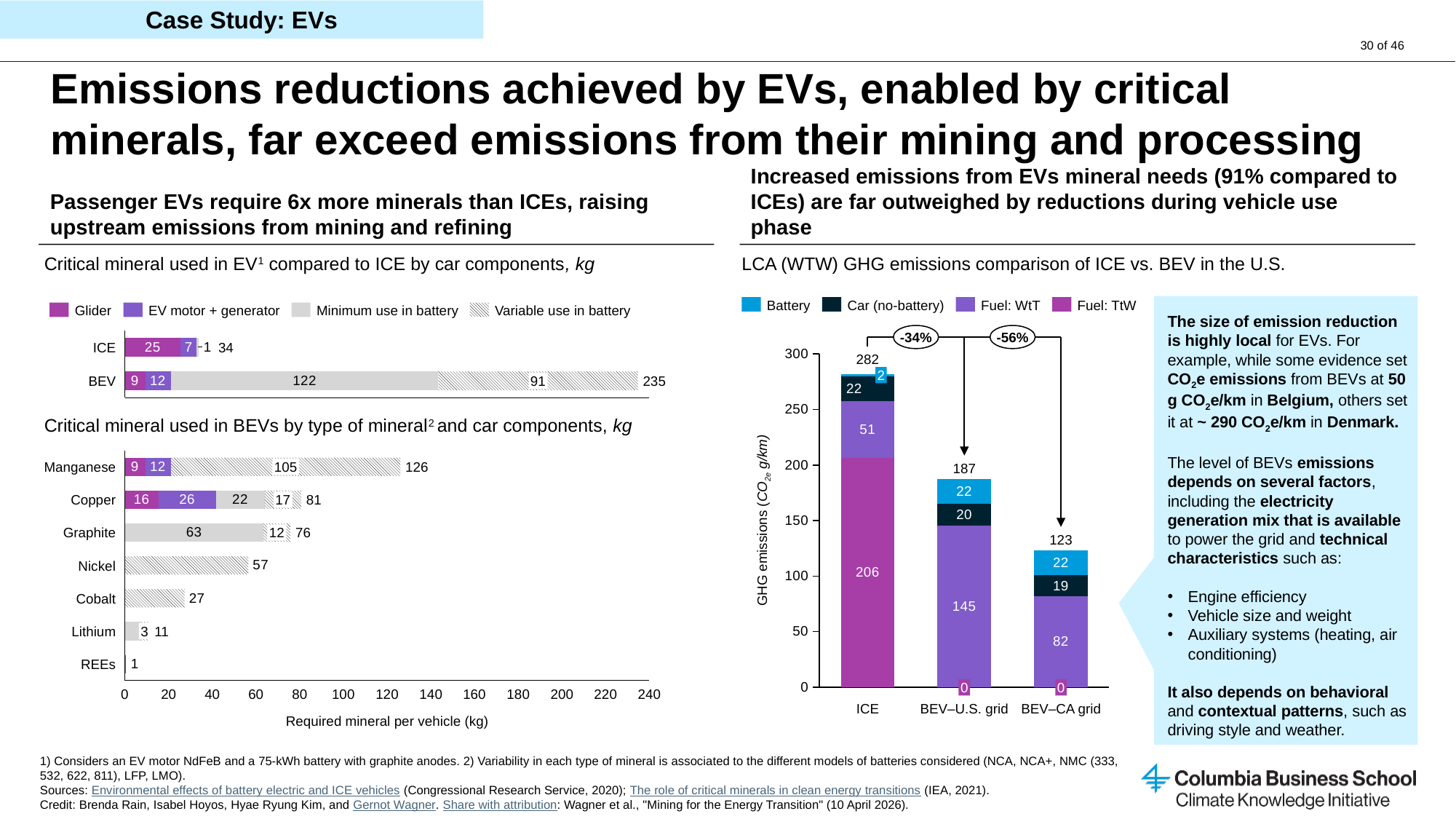
In the chart 'Critical mineral used in BEVs by type of mineral and car components, kg', what is the total for Copper? 81 In the chart 'LCA (WTW) GHG emissions comparison of ICE vs. BEV in the U.S.', what is the difference between the total for ICE and the total for BEV–CA grid? 159 In the chart 'LCA (WTW) GHG emissions comparison of ICE vs. BEV in the U.S.', how many series does the legend list? 4 In the chart 'Critical mineral used in EV compared to ICE by car components, kg', what is the total for BEV? 235 In the chart 'Critical mineral used in EV compared to ICE by car components, kg', what is the Glider value for ICE? 25 In the chart 'LCA (WTW) GHG emissions comparison of ICE vs. BEV in the U.S.', what is the Fuel: WtT value for BEV–U.S. grid? 145 In the chart 'LCA (WTW) GHG emissions comparison of ICE vs. BEV in the U.S.', which category has the lowest total emissions? BEV–CA grid In the chart 'Critical mineral used in BEVs by type of mineral and car components, kg', which mineral has the highest total? Manganese In the chart 'LCA (WTW) GHG emissions comparison of ICE vs. BEV in the U.S.', what is the total GHG emissions value for ICE? 282 What kind of chart is 'Critical mineral used in BEVs by type of mineral and car components, kg'? Stacked bar chart In the chart 'LCA (WTW) GHG emissions comparison of ICE vs. BEV in the U.S.', what is the Fuel: TtW value for ICE? 206 In the chart 'Critical mineral used in BEVs by type of mineral and car components, kg', how many minerals are listed on the axis? 7